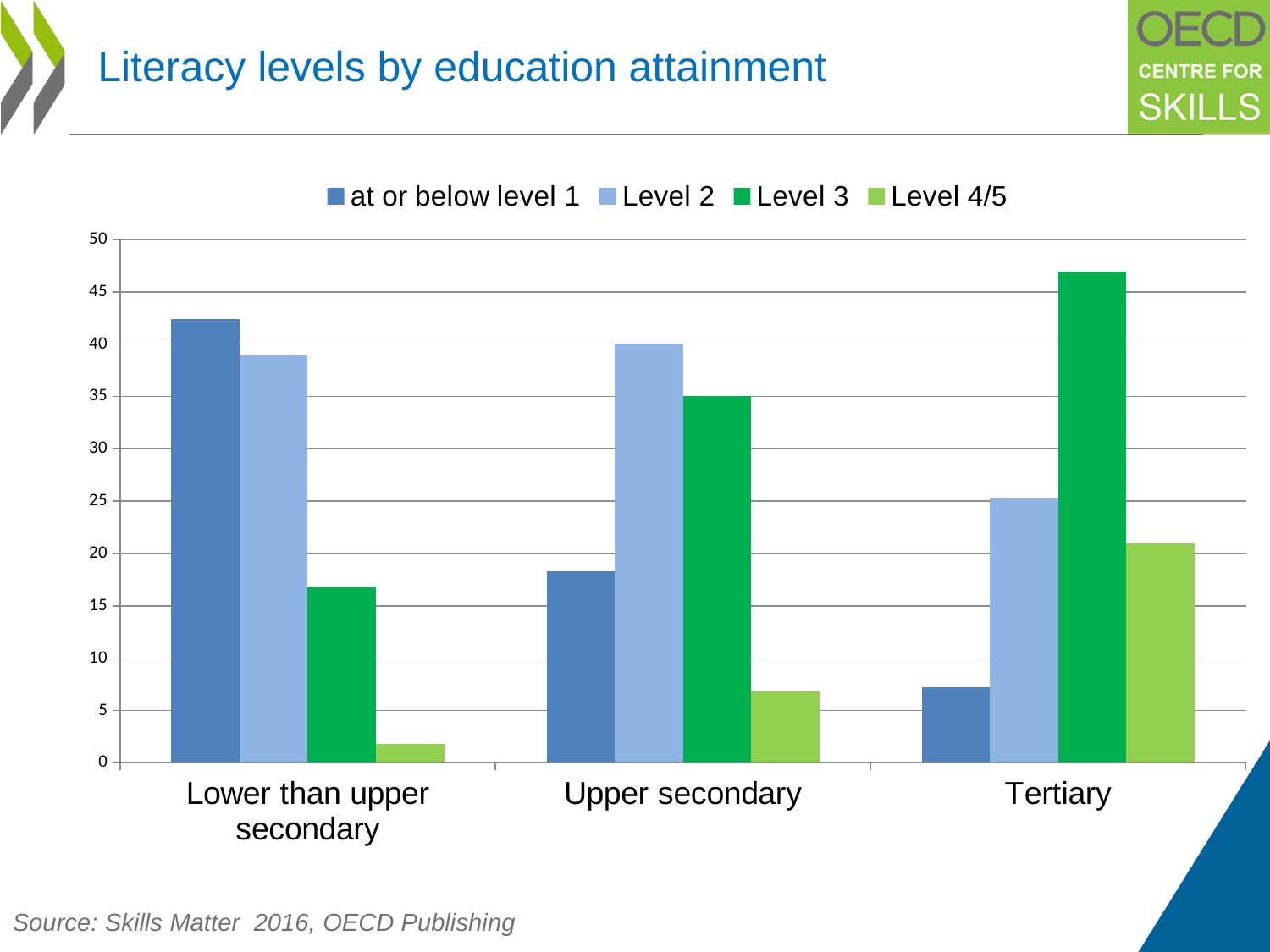
Which is larger: the 'at or below level 1' bar for Lower than upper secondary or for Tertiary? Lower than upper secondary How many education attainment categories are shown on the x axis? 3 Is the Level 3 value for Tertiary greater or less than 45? greater Which education attainment category has the lowest Level 4/5 bar? Lower than upper secondary What is the title of the slide containing the chart? Literacy levels by education attainment Is the Level 2 value for Upper secondary greater or less than 35? greater Do the 'at or below level 1' values rise or fall moving from Lower than upper secondary to Tertiary? fall How many series does the legend list? 4 What kind of chart is shown on the slide? bar chart Within the Tertiary category, which literacy level has the tallest bar? Level 3 Which education attainment category has the highest Level 3 bar? Tertiary Is the Level 4/5 value for Lower than upper secondary greater or less than 5? less